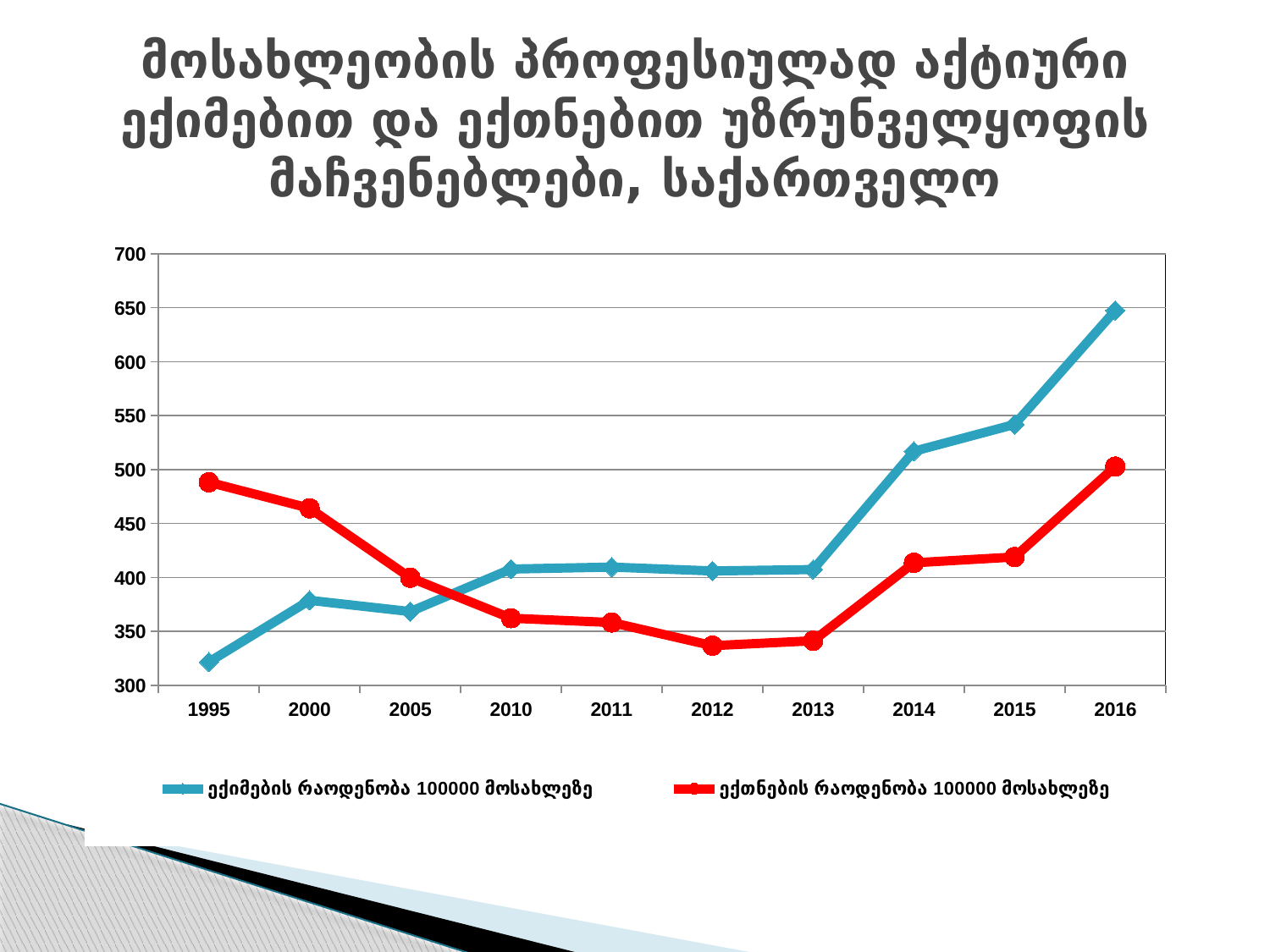
Which year has the highest value for the red series (ექთნების რაოდენობა 100000 მოსახლეზე)? 2016 In 2016, which series has the larger value: the blue series (ექიმების რაოდენობა 100000 მოსახლეზე) or the red series (ექთნების რაოდენობა 100000 მოსახლეზე)? ექიმების რაოდენობა 100000 მოსახლეზე (blue) In 1995, which series has the larger value: the blue series (ექიმების რაოდენობა 100000 მოსახლეზე) or the red series (ექთნების რაოდენობა 100000 მოსახლეზე)? ექთნების რაოდენობა 100000 მოსახლეზე (red) Is the value for the blue series (ექიმების რაოდენობა 100000 მოსახლეზე) in 2016 greater or less than 600? greater Is the value for the blue series (ექიმების რაოდენობა 100000 მოსახლეზე) in 1995 greater or less than 350? less Does the red series (ექთნების რაოდენობა 100000 მოსახლეზე) rise or fall from 1995 to 2012? fall What kind of chart is shown on the slide? line chart Which year has the lowest value for the blue series (ექიმების რაოდენობა 100000 მოსახლეზე)? 1995 How many series does the legend list? 2 How many years are plotted along the x axis? 10 Which year has the highest value for the blue series (ექიმების რაოდენობა 100000 მოსახლეზე)? 2016 Is the value for the red series (ექთნების რაოდენობა 100000 მოსახლეზე) in 2012 greater or less than 350? less